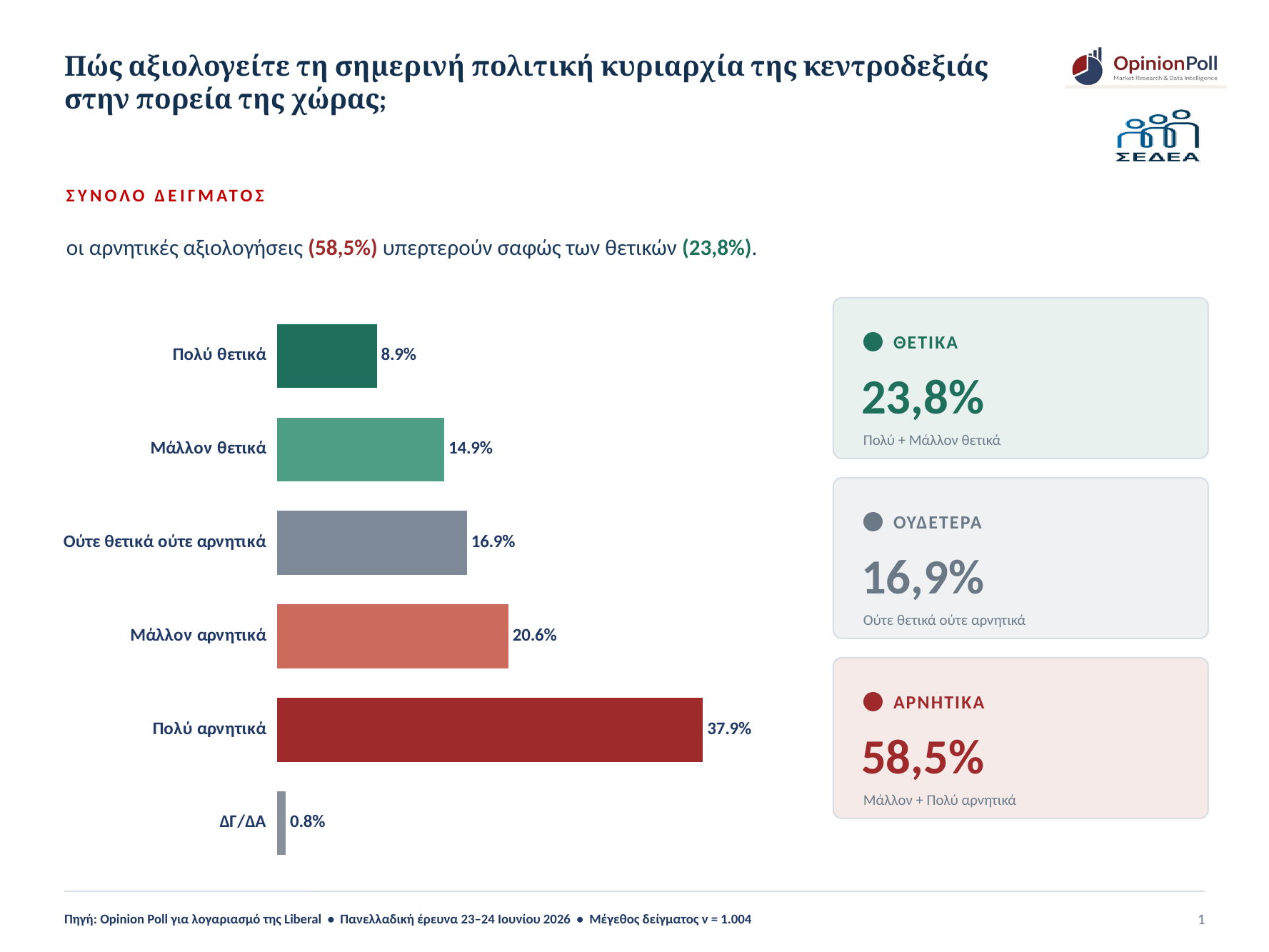
What is the value for Πολύ θετικά? 8.9% What kind of chart is shown on the slide? Bar chart What is the value for ΔΓ/ΔΑ? 0.8% Which is larger, Μάλλον θετικά or Μάλλον αρνητικά? Μάλλον αρνητικά Which category has the lowest value? ΔΓ/ΔΑ What is the difference between Πολύ αρνητικά and Μάλλον αρνητικά? 17.3% How many categories are shown in the bar chart? 6 Which category has the highest value? Πολύ αρνητικά What is the difference between Ούτε θετικά ούτε αρνητικά and Μάλλον θετικά? 2.0% What is the combined value shown for ΑΡΝΗΤΙΚΑ (Μάλλον + Πολύ αρνητικά) in the summary box? 58,5% What is the combined value shown for ΘΕΤΙΚΑ (Πολύ + Μάλλον θετικά) in the summary box? 23,8% What is the value for Μάλλον αρνητικά? 20.6%